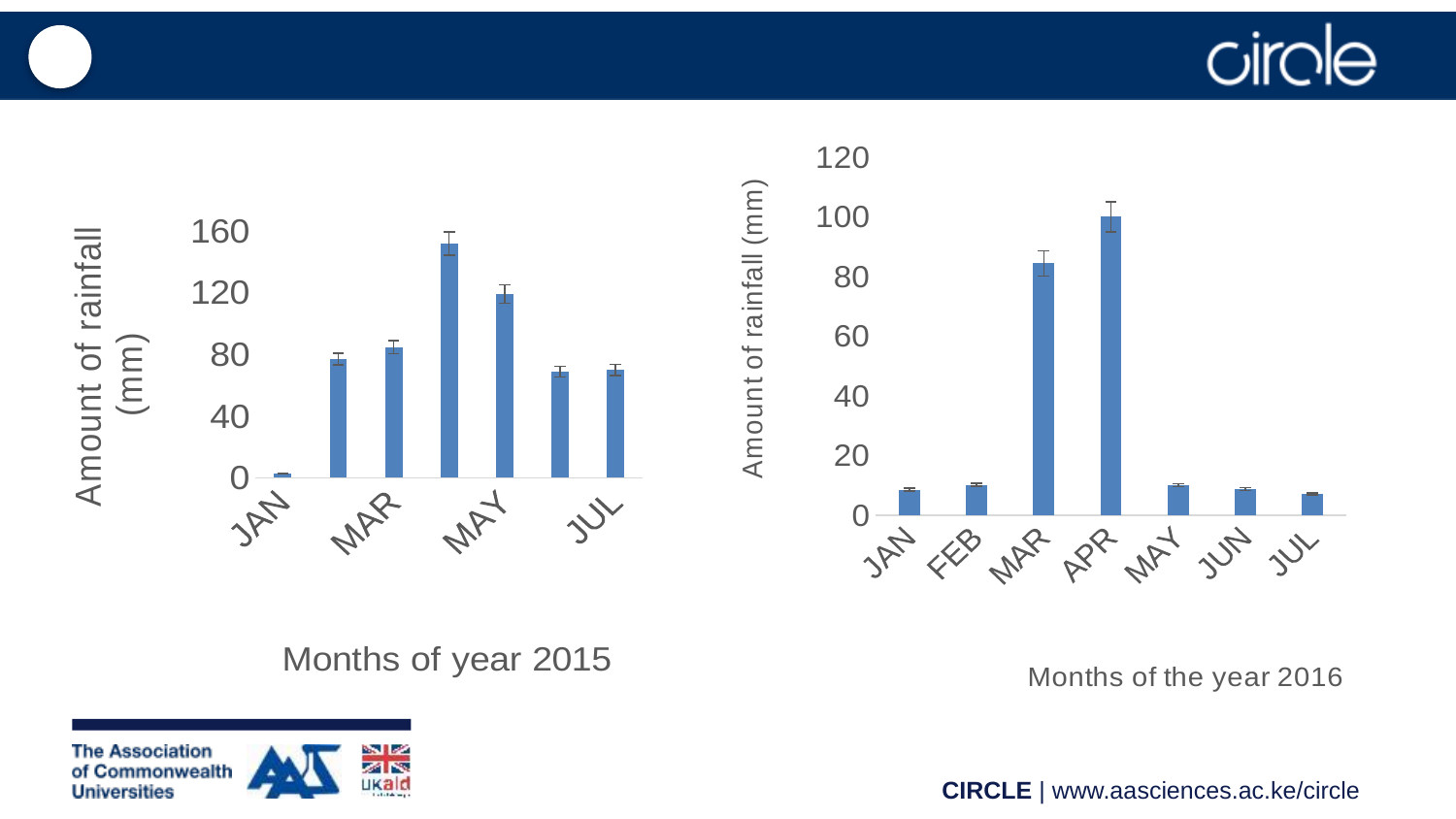
In the chart titled 'Months of year 2015', is the value for MAY greater or less than 80? greater How many bars are plotted in the chart titled 'Months of year 2015'? 7 In the chart titled 'Months of the year 2016', is the value for APR greater or less than 80? greater How many bars are plotted in the chart titled 'Months of the year 2016'? 7 In the chart titled 'Months of the year 2016', is the value for MAY greater or less than 20? less In the chart titled 'Months of the year 2016', which month has the highest rainfall? APR In the chart titled 'Months of the year 2016', which is larger, the value for JAN or the value for MAR? MAR What is the y-axis title of the chart titled 'Months of the year 2016'? Amount of rainfall (mm) In the chart titled 'Months of year 2015', which is larger, the value for MAR or the value for MAY? MAY What kind of chart is the chart titled 'Months of year 2015'? bar chart In the chart titled 'Months of year 2015', which labelled month has the lowest rainfall? JAN